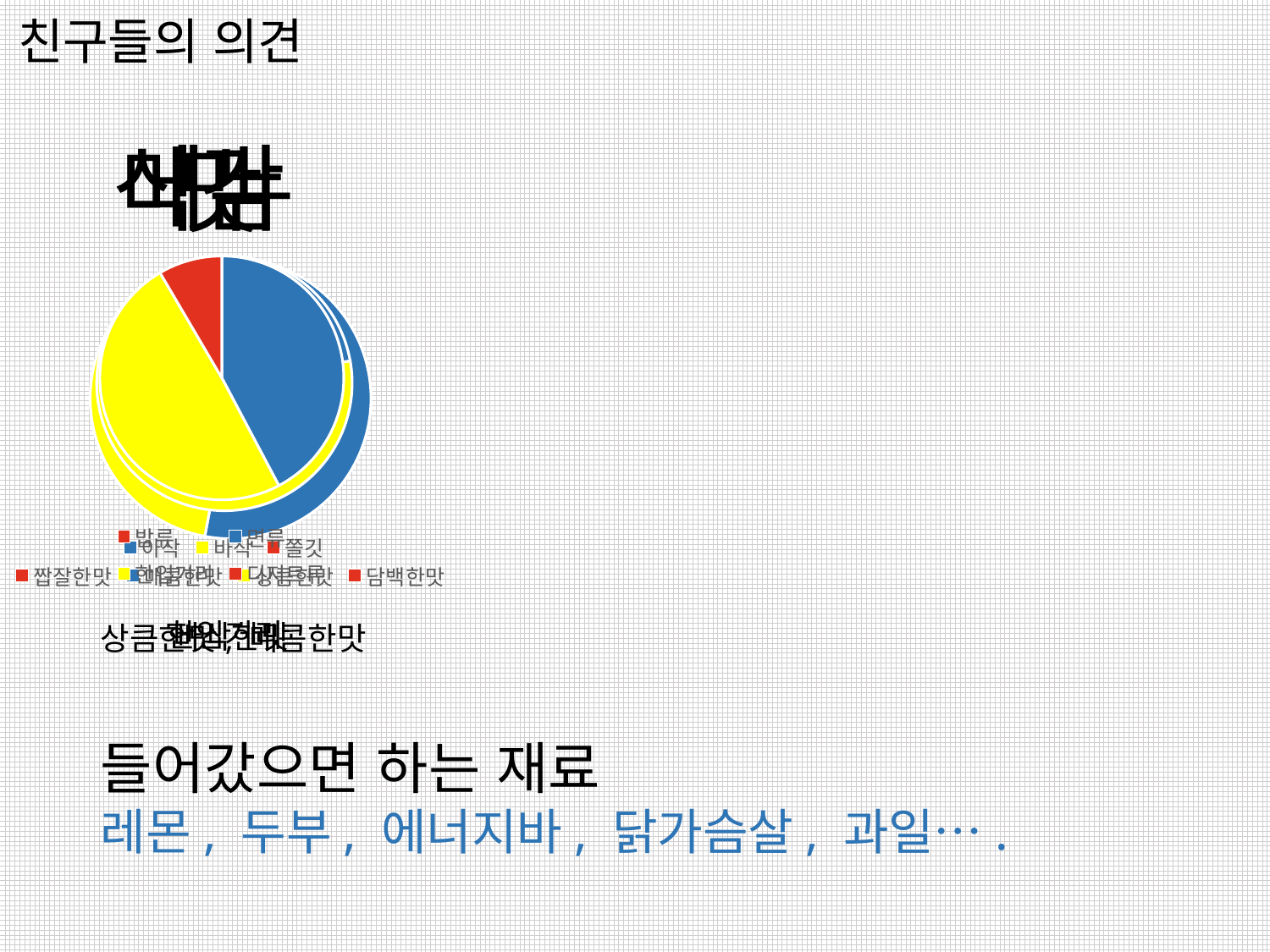
Which three colours are used for the slices of the front pie chart? blue, yellow and red In the front pie chart, which colour slice is the smallest? red What kind of chart is shown on the slide? pie chart